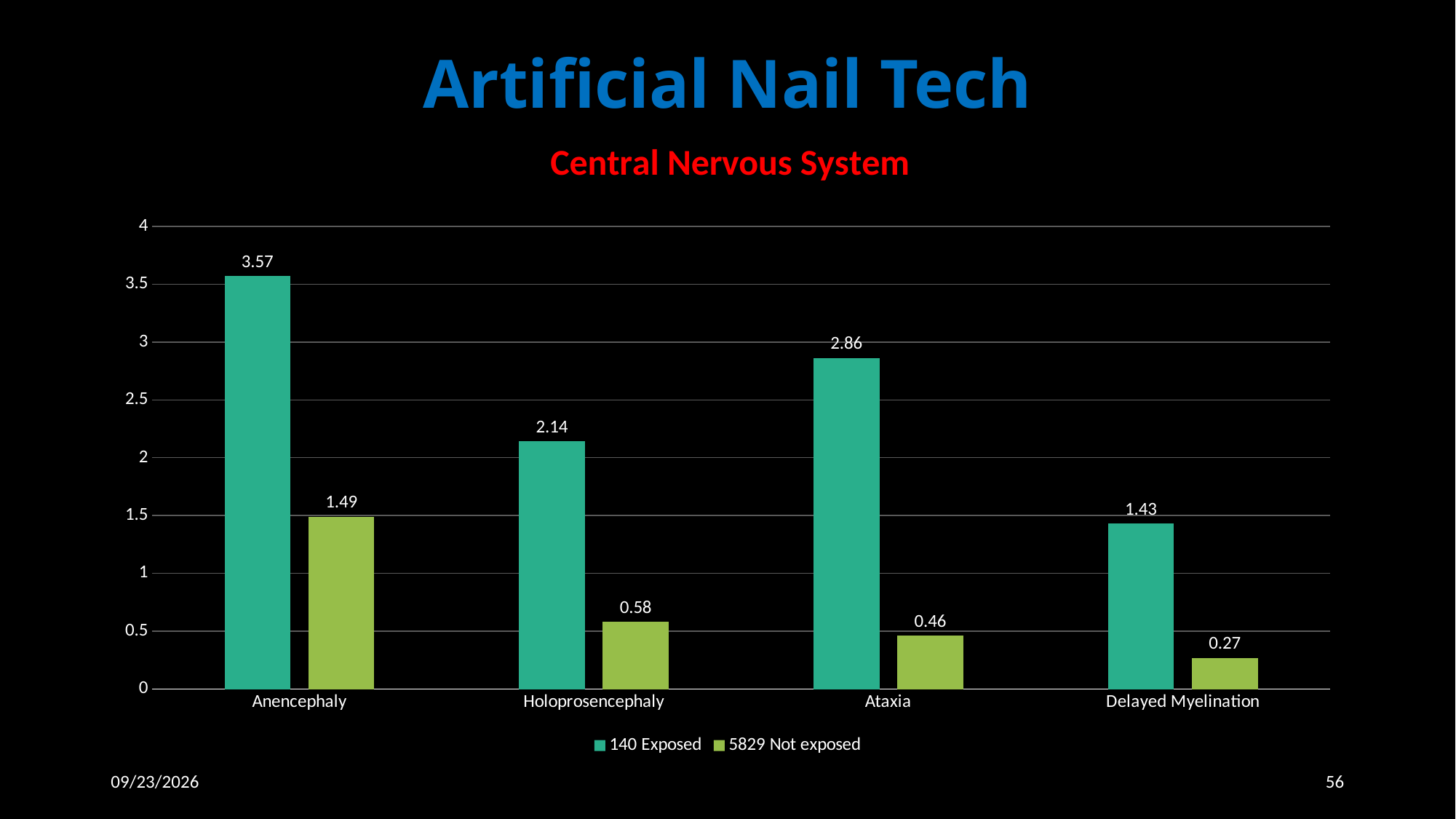
Which category has the lowest value in the 5829 Not exposed series? Delayed Myelination What is the value for Delayed Myelination in the 140 Exposed series? 1.43 What is the title shown in red above the chart? Central Nervous System What is the difference between the 140 Exposed and 5829 Not exposed values for Holoprosencephaly? 1.56 How many categories are shown on the x axis? 4 Which category has the highest value in the 140 Exposed series? Anencephaly Which is larger: the 140 Exposed value for Ataxia or the 140 Exposed value for Holoprosencephaly? Ataxia Is the 5829 Not exposed value for Anencephaly greater or less than 1? greater How many series does the legend list? 2 What is the value for Anencephaly in the 140 Exposed series? 3.57 What is the value for Ataxia in the 5829 Not exposed series? 0.46 What kind of chart is shown on the slide? Bar chart